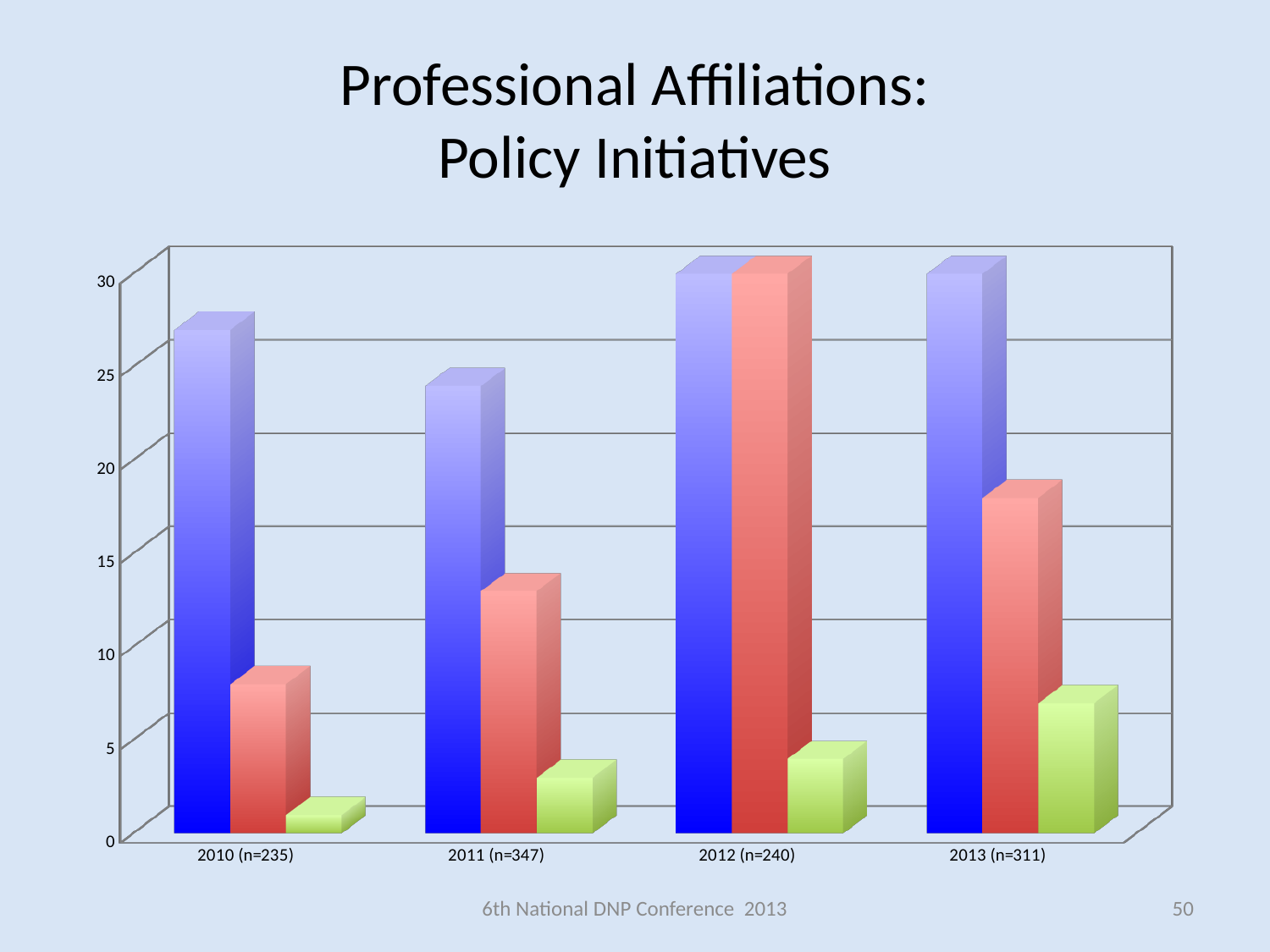
Is the value of the green bar for 2013 (n=311) greater or less than 5? greater Do the green bars rise or fall from 2010 to 2013? rise How many bars are plotted for each year category? 3 Which year has the highest red bar? 2012 (n=240) Is the value of the red bar for 2010 (n=235) greater or less than 10? less How many year categories are shown on the x axis? 4 Which is larger for 2010 (n=235), the blue bar or the red bar? the blue bar Which year has the lowest green bar? 2010 (n=235) Is the value of the red bar for 2011 (n=347) greater or less than 10? greater What kind of chart is shown on the slide? bar chart